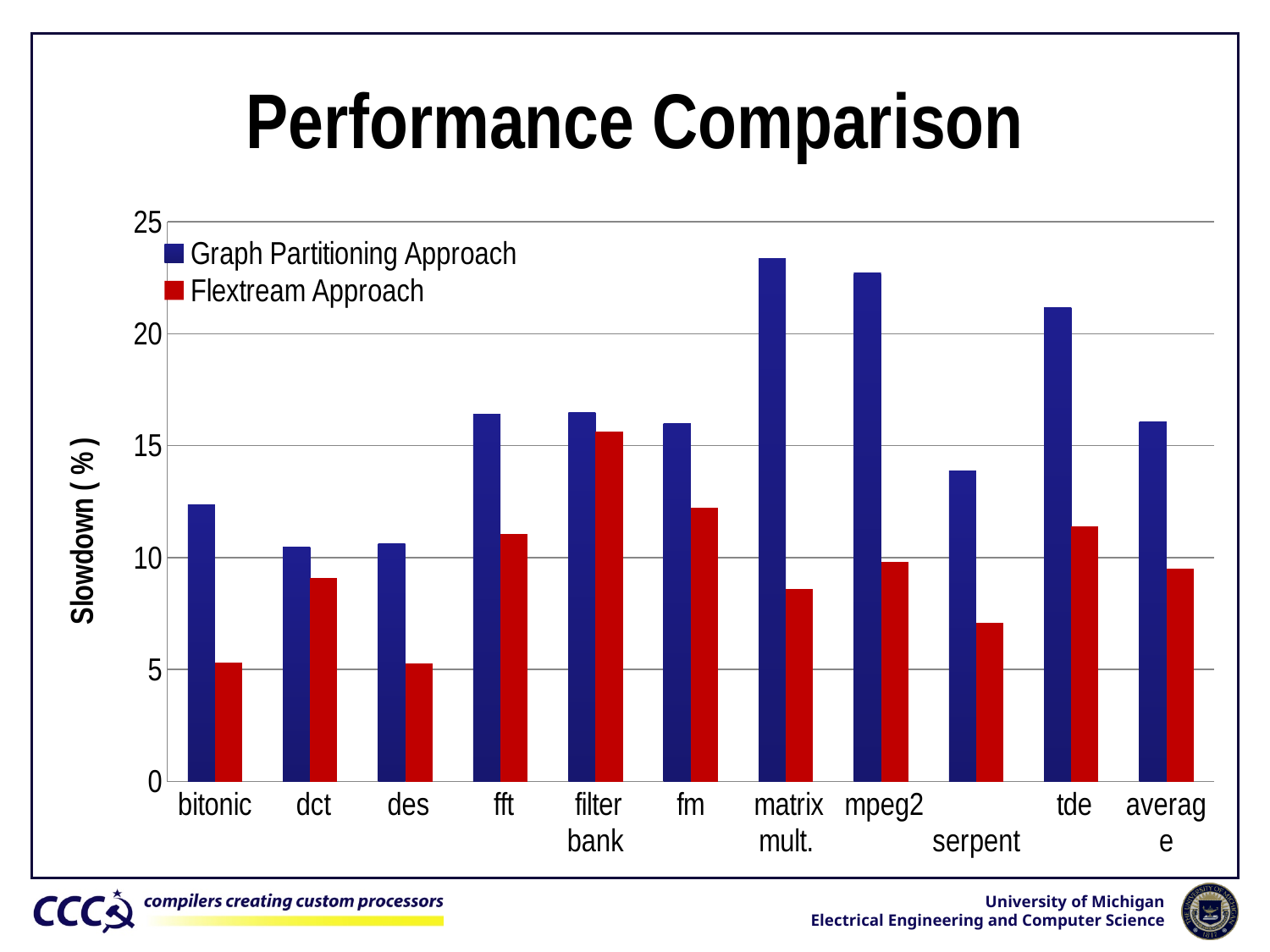
How many series does the legend list? 2 Which category has the highest value for the Graph Partitioning Approach? matrix mult. How many categories are shown along the x axis? 11 Is the Graph Partitioning Approach value for tde greater or less than 20? greater Is the Flextream Approach value for serpent greater or less than 10? less What is the label of the y axis? Slowdown ( % ) Is the Graph Partitioning Approach value for bitonic greater or less than 10? greater What colour are the bars for the Flextream Approach? red What kind of chart is shown on the slide? bar chart Which category has the highest value for the Flextream Approach? filter bank For matrix mult., which series has the larger value: Graph Partitioning Approach or Flextream Approach? Graph Partitioning Approach